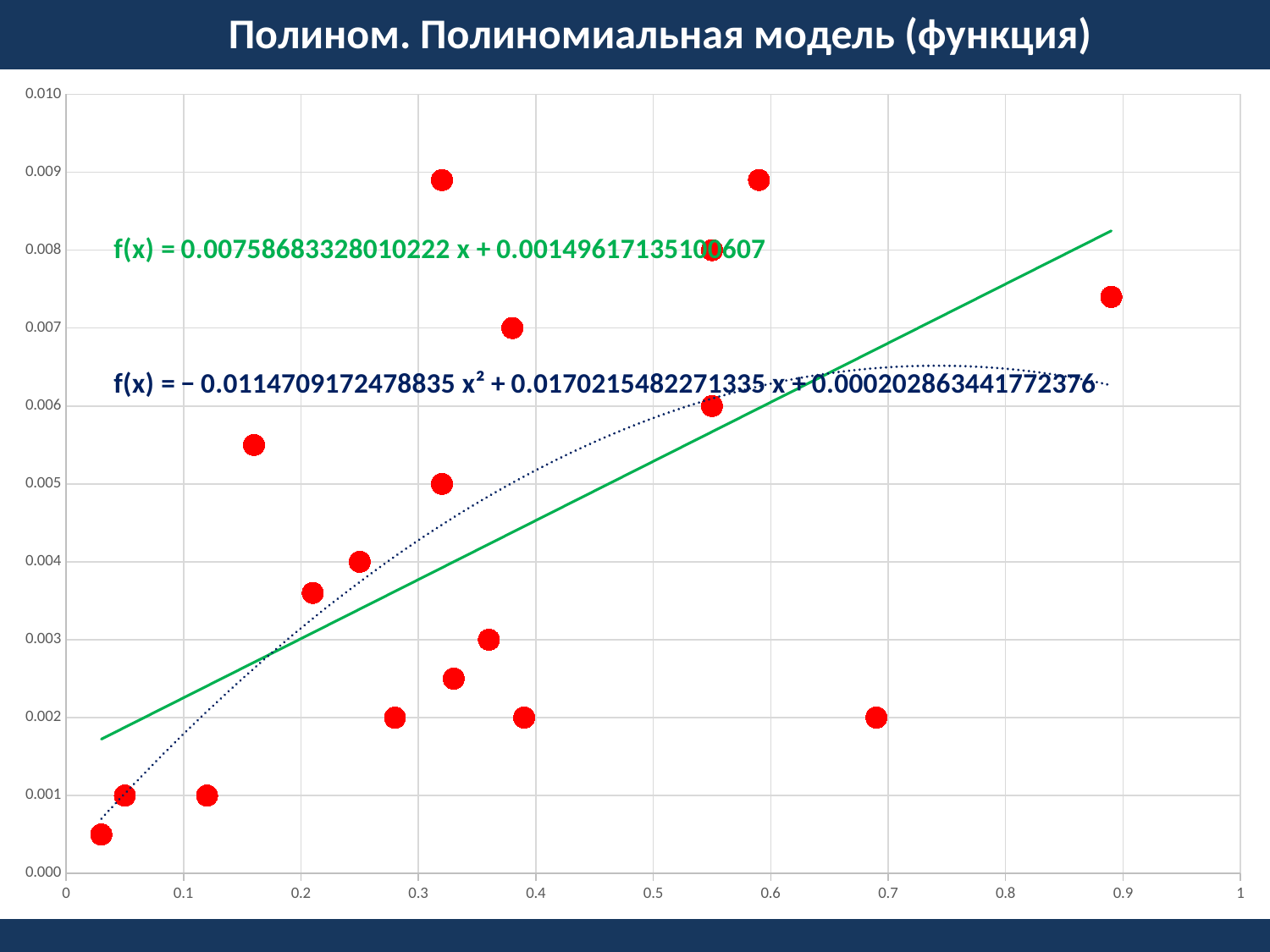
Does the green linear trendline rise or fall as x increases? rises What kind of chart is shown on the slide? scatter chart What is the equation shown for the dotted polynomial trendline? f(x) = − 0.0114709172478835 x² + 0.0170215482271335 x + 0.000202863441772376 What is the highest value shown on the y axis? 0.010 What is the equation shown for the green linear trendline? f(x) = 0.00758683328010222 x + 0.00149617135100607 Is the value of the lowest data point (near x = 0.03) greater or less than 0.001? less Which is larger: the value of the data point near x = 0.38 (upper) or the data point near x = 0.39 (lower)? the point near x = 0.38 Is the value of the data point near x = 0.7 greater or less than 0.003? less Is the value of the data point near x = 0.16 greater or less than 0.005? greater